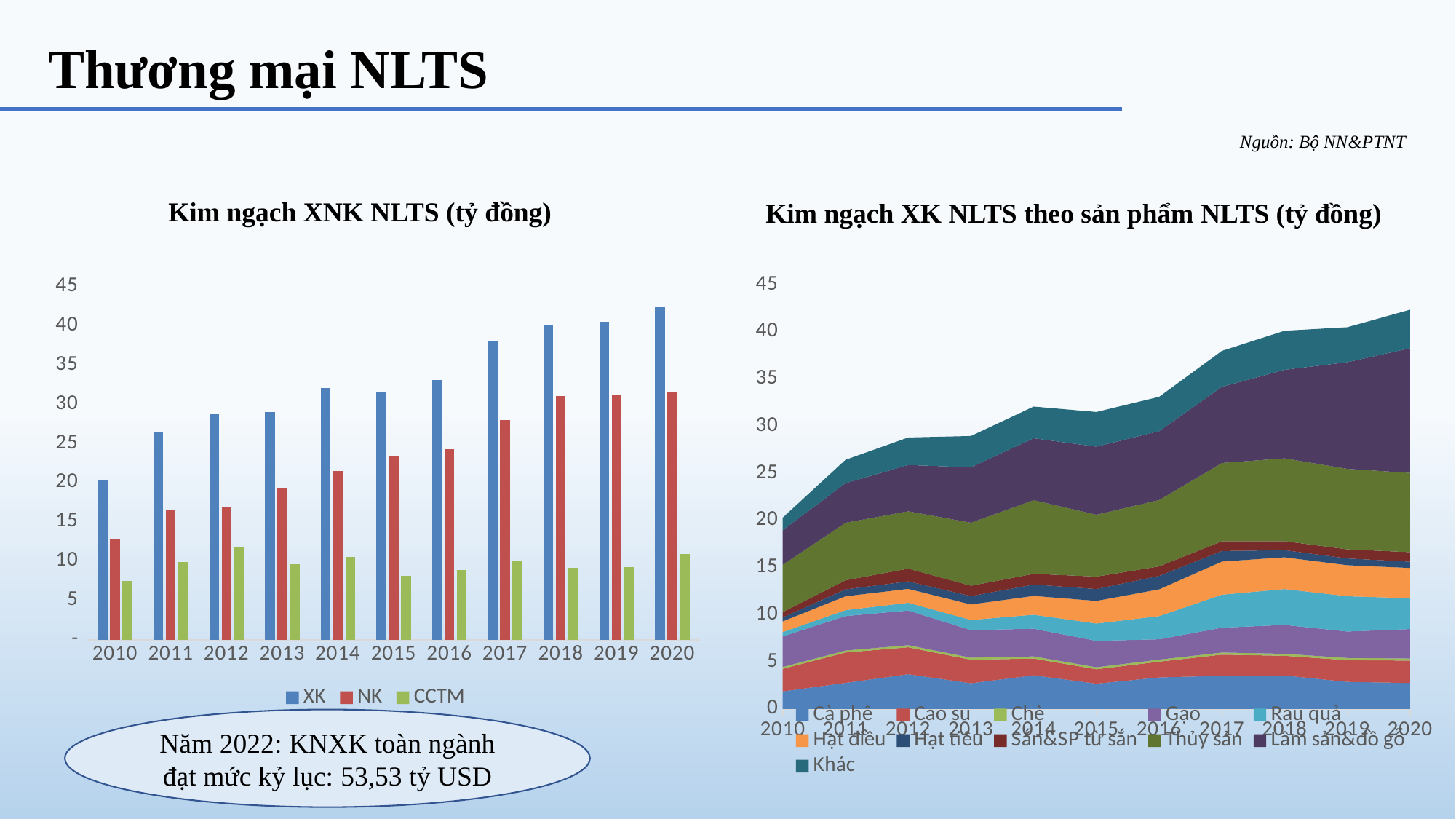
How many years are shown on the x axis of the left chart "Kim ngạch XNK NLTS (tỷ đồng)"? 11 How many series does the legend of the right chart "Kim ngạch XK NLTS theo sản phẩm NLTS (tỷ đồng)" list? 11 In the left chart "Kim ngạch XNK NLTS (tỷ đồng)", is the CCTM value for 2015 greater or less than 10? less In the left chart "Kim ngạch XNK NLTS (tỷ đồng)", which year has the lowest XK value? 2010 What kind of chart is the right chart titled "Kim ngạch XK NLTS theo sản phẩm NLTS (tỷ đồng)"? stacked area chart In the left chart "Kim ngạch XNK NLTS (tỷ đồng)", which year has the highest XK value? 2020 In the right chart "Kim ngạch XK NLTS theo sản phẩm NLTS (tỷ đồng)", is the total stacked value for 2020 greater or less than 40? greater In the left chart "Kim ngạch XNK NLTS (tỷ đồng)", does the XK series generally rise or fall from 2010 to 2020? rise In the left chart "Kim ngạch XNK NLTS (tỷ đồng)", which is larger in 2020, XK or NK? XK What kind of chart is the left chart titled "Kim ngạch XNK NLTS (tỷ đồng)"? bar chart How many series does the legend of the left chart "Kim ngạch XNK NLTS (tỷ đồng)" list? 3 In the left chart "Kim ngạch XNK NLTS (tỷ đồng)", is the XK value for 2020 greater or less than 40? greater